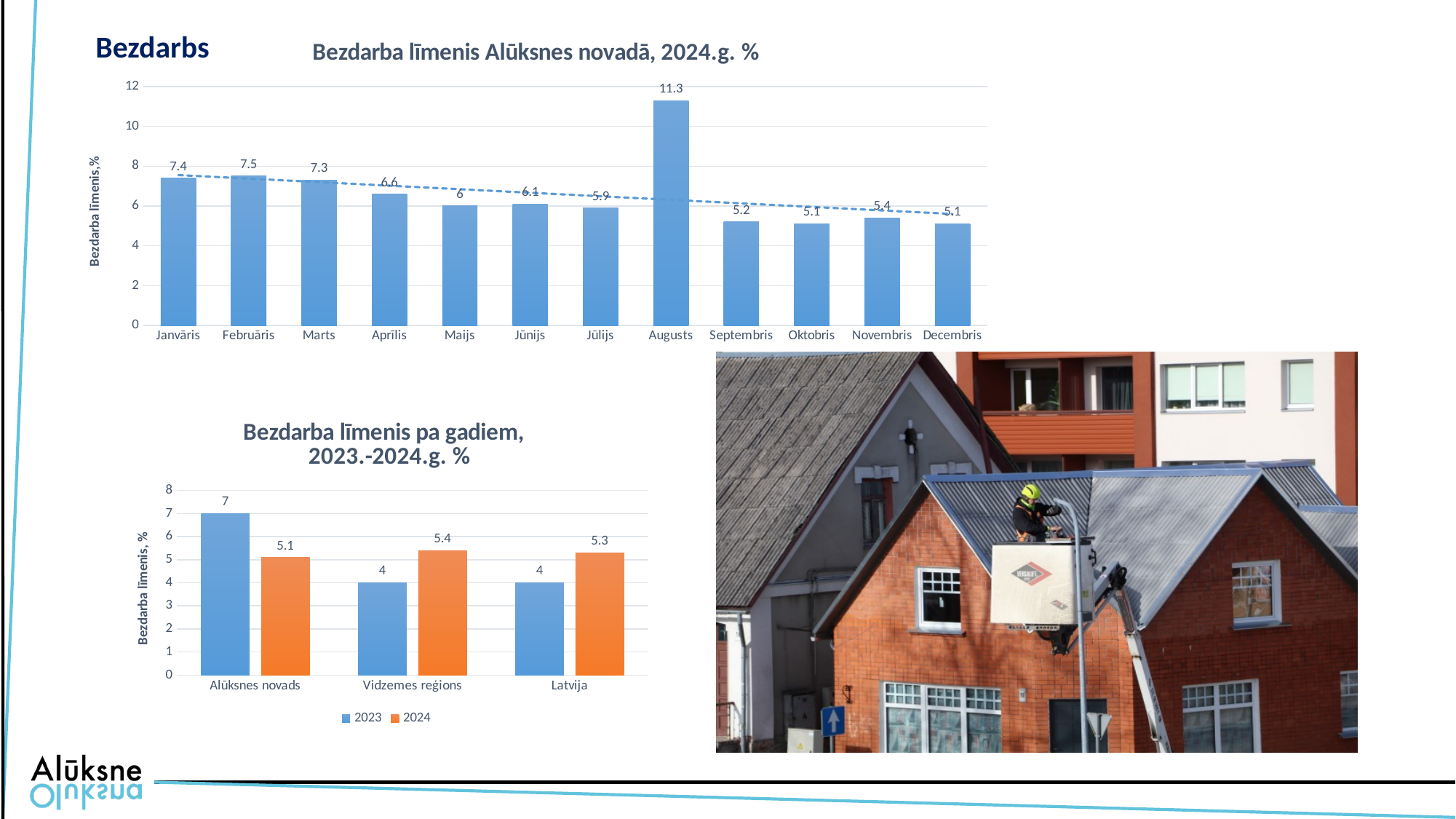
What kind of chart is 'Bezdarba līmenis pa gadiem, 2023.-2024.g. %'? bar chart In the chart 'Bezdarba līmenis pa gadiem, 2023.-2024.g. %', how many series does the legend list? 2 In the chart 'Bezdarba līmenis Alūksnes novadā, 2024.g. %', what is the value for Augusts? 11.3 In the chart 'Bezdarba līmenis pa gadiem, 2023.-2024.g. %', what is the 2023 value for Alūksnes novads? 7 In the chart 'Bezdarba līmenis Alūksnes novadā, 2024.g. %', how many months are shown on the x axis? 12 In the chart 'Bezdarba līmenis Alūksnes novadā, 2024.g. %', what is the value for Aprīlis? 6.6 In the chart 'Bezdarba līmenis pa gadiem, 2023.-2024.g. %', what is the difference between the 2023 and 2024 values for Latvija? 1.3 In the chart 'Bezdarba līmenis Alūksnes novadā, 2024.g. %', which month has the highest value? Augusts In the chart 'Bezdarba līmenis Alūksnes novadā, 2024.g. %', is the value for Februāris greater or less than the value for Jūlijs? greater In the chart 'Bezdarba līmenis Alūksnes novadā, 2024.g. %', what is the value for Decembris? 5.1 In the chart 'Bezdarba līmenis pa gadiem, 2023.-2024.g. %', what is the 2024 value for Vidzemes reģions? 5.4 In the chart 'Bezdarba līmenis Alūksnes novadā, 2024.g. %', what is the difference between the values for Augusts and Septembris? 6.1